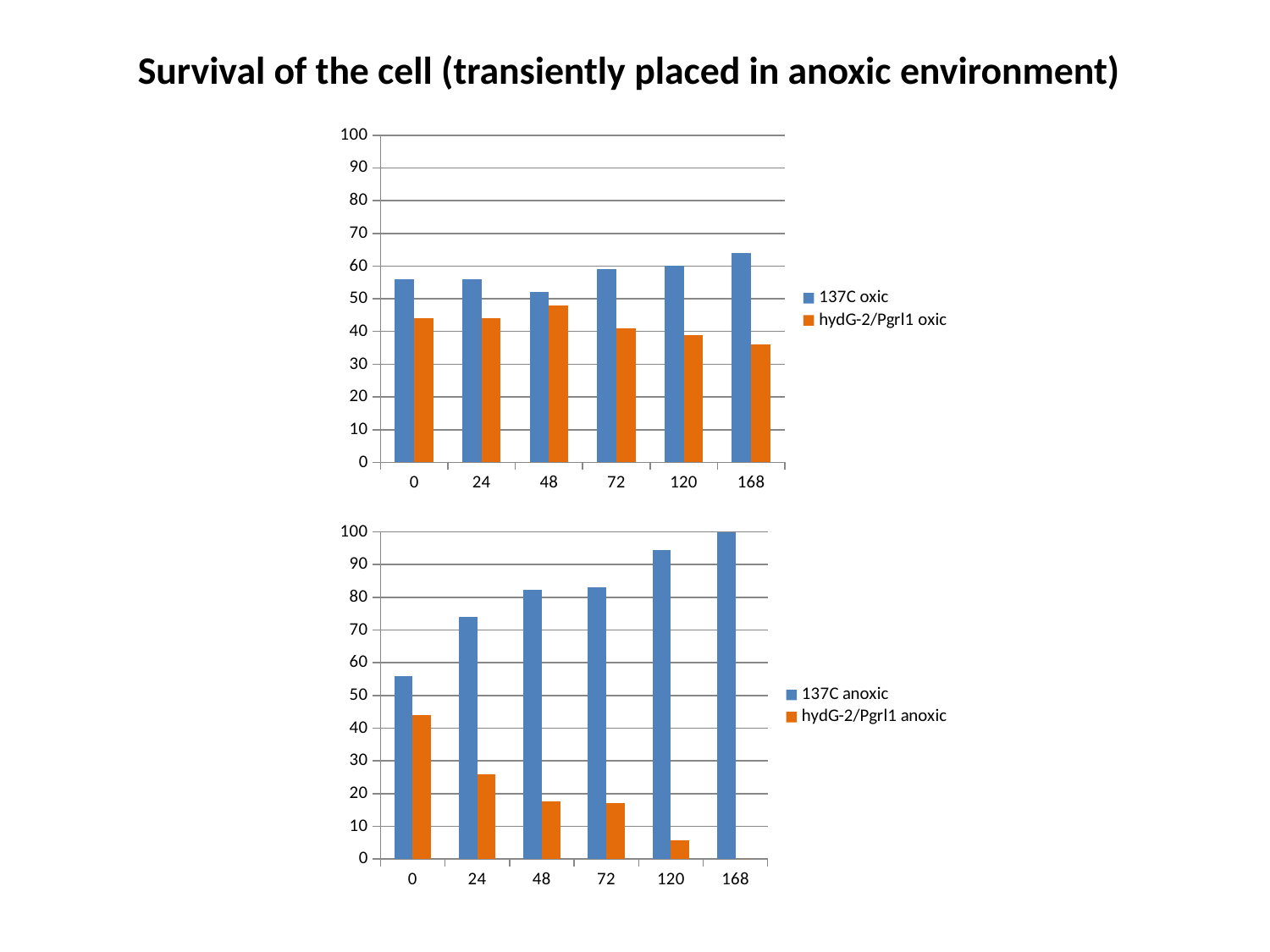
In the bottom chart, is the value for hydG-2/Pgrl1 anoxic at 120 greater or less than 10? less How many series does the legend of the bottom chart list? 2 In the top chart, which category has the lowest value for hydG-2/Pgrl1 oxic? 168 In the bottom chart, does the value for hydG-2/Pgrl1 anoxic rise or fall from 0 to 120? fall How many categories are shown on the x axis of the top chart? 6 In the bottom chart, does the value for 137C anoxic rise or fall from 0 to 168? rise In the top chart, which category has the highest value for 137C oxic? 168 What kind of chart is the top chart on the slide? bar chart In the bottom chart, which category has the highest value for 137C anoxic? 168 In the bottom chart, which is larger at 24: 137C anoxic or hydG-2/Pgrl1 anoxic? 137C anoxic In the top chart, is the value for 137C oxic at 168 greater or less than 60? greater